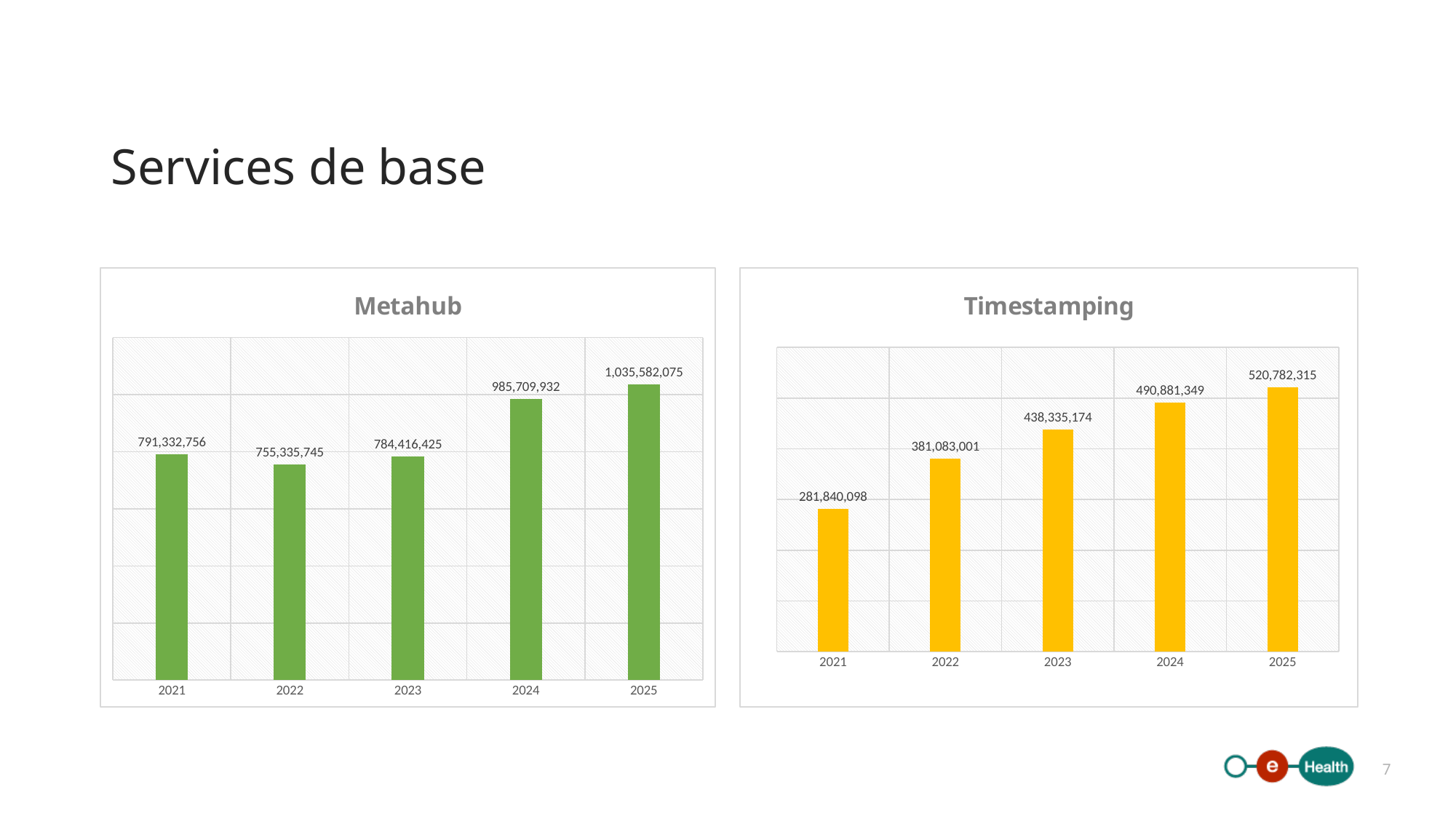
In the Metahub chart, what is the difference between the 2025 and 2024 values? 49,872,143 In the Metahub chart, which year has the lowest value? 2022 In the Metahub chart, which year has the highest value? 2025 What kind of chart is the Metahub chart? bar chart In the Timestamping chart, what is the difference between the 2025 and 2021 values? 238,942,217 In the Metahub chart, which is larger, the value for 2021 or the value for 2023? 2021 What colour are the bars in the Timestamping chart? yellow In the Timestamping chart, which year has the lowest value? 2021 In the Timestamping chart, do the values rise or fall from 2021 to 2025? rise How many years are shown on the x axis of the Timestamping chart? 5 In the Timestamping chart, what is the value for 2022? 381,083,001 In the Metahub chart, what is the value for 2024? 985,709,932